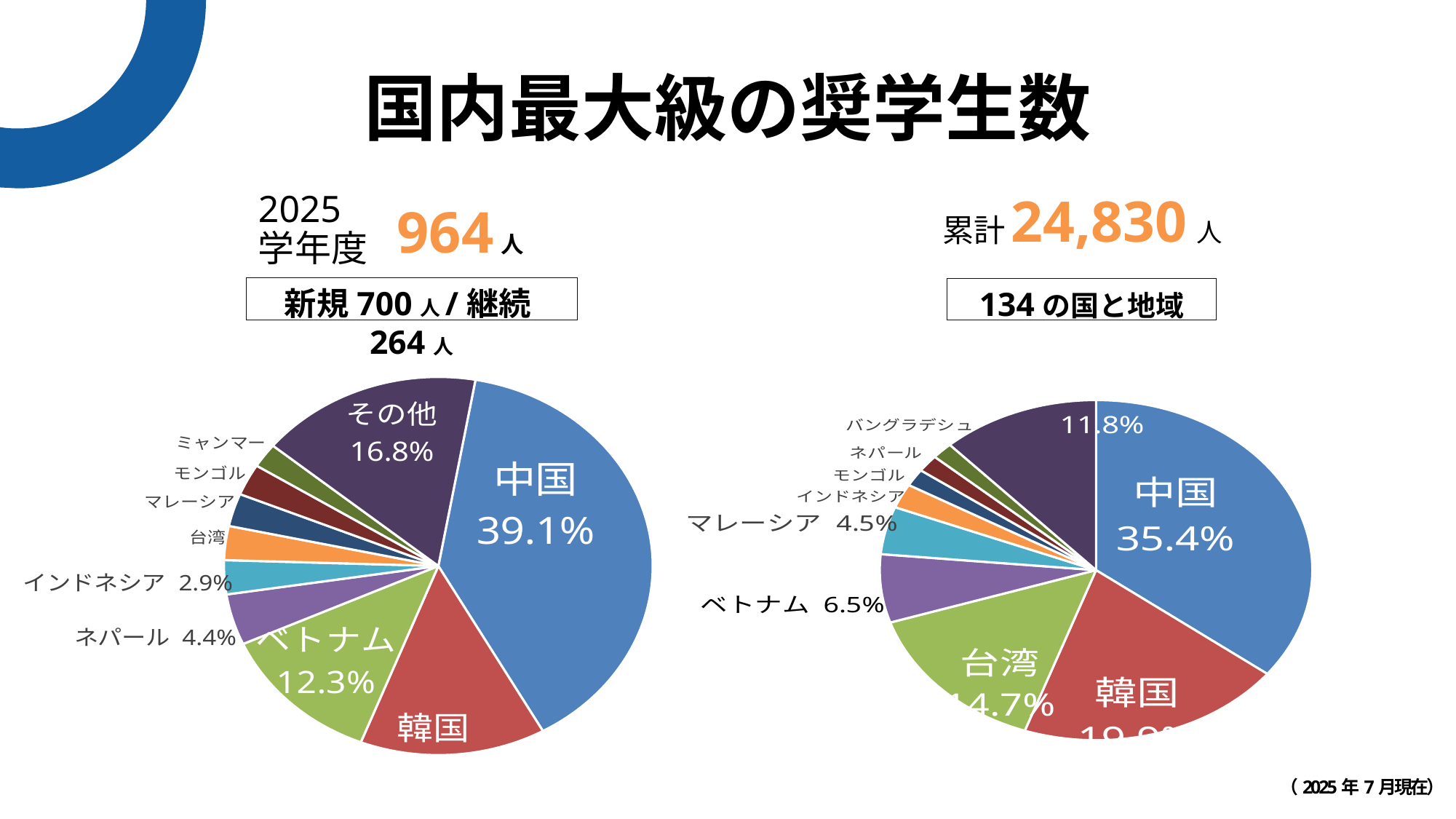
In the left pie chart (2025学年度), which country has the largest slice? 中国 In the right pie chart (累計), which is larger, the slice for 中国 or the slice for 韓国? 中国 In the left pie chart (2025学年度), what share is shown for 中国? 39.1% In the right pie chart (累計), what share is shown for 中国? 35.4% In the left pie chart (2025学年度), what share is shown for ベトナム? 12.3% What kind of chart is used on this slide? Pie chart In the left pie chart (2025学年度), how many percentage points larger is 中国's share than ベトナム's share? 26.8 percentage points